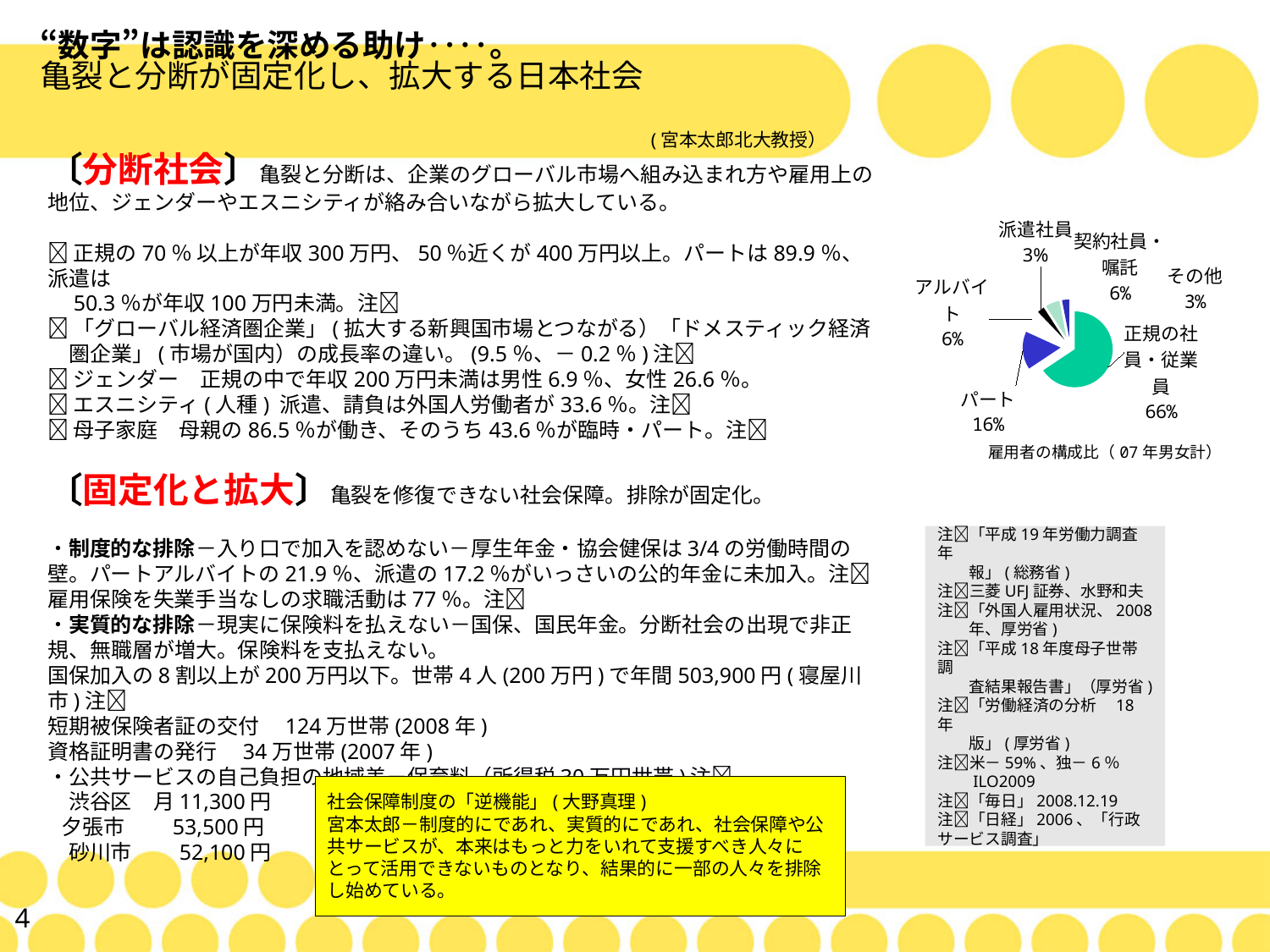
What share of the pie does 契約社員・嘱託 represent? 6% What share of the pie does アルバイト represent? 6% What share of the pie does その他 represent? 3% Which category has the largest share of the pie? 正規の社員・従業員 How many slices does the pie chart have? 6 What share of the pie does 正規の社員・従業員 represent? 66% Which is larger, the share for パート or the share for アルバイト? パート What type of chart is shown on the slide? pie chart What share of the pie does パート represent? 16% What share of the pie does 派遣社員 represent? 3% What is the difference in percentage points between 正規の社員・従業員 and パート? 50 What is the title (caption) of the pie chart? 雇用者の構成比（07年男女計）